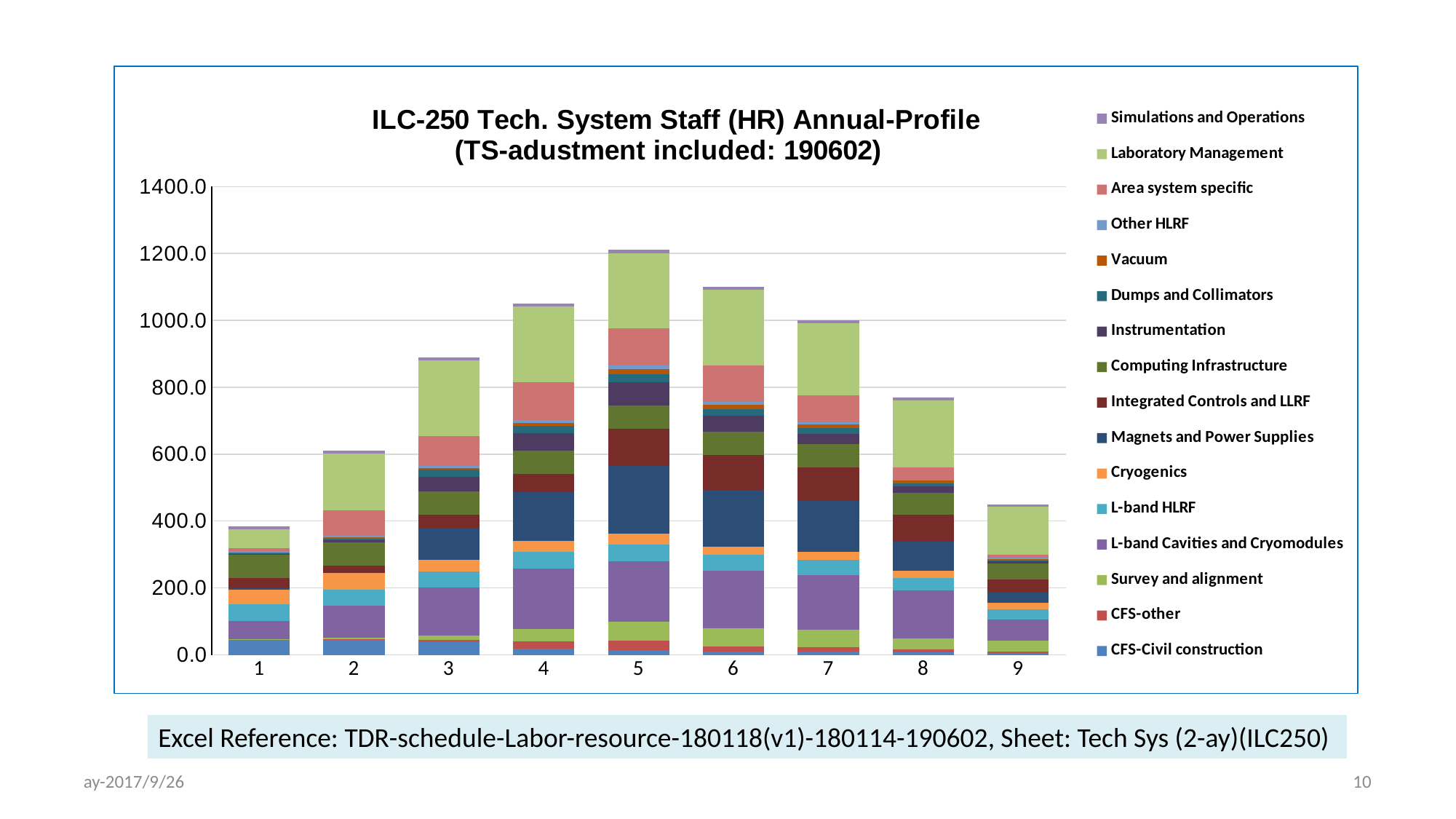
Is the total for year 8 greater or less than 800? less What kind of chart is shown on the slide? Stacked bar chart What is the title of the chart? ILC-250 Tech. System Staff (HR) Annual-Profile (TS-adustment included: 190602) How many categories (years) are shown on the x axis of the chart? 9 Which year has the shortest stacked bar in the chart? 1 Is the total for year 4 greater or less than 1000? greater Is the total for year 9 greater or less than 600? less Which has the larger total stacked bar, year 6 or year 7? Year 6 How many series does the legend of the chart list? 16 Which year has the tallest stacked bar in the chart? 5 Do the stacked bar totals rise or fall from year 5 to year 9? Fall